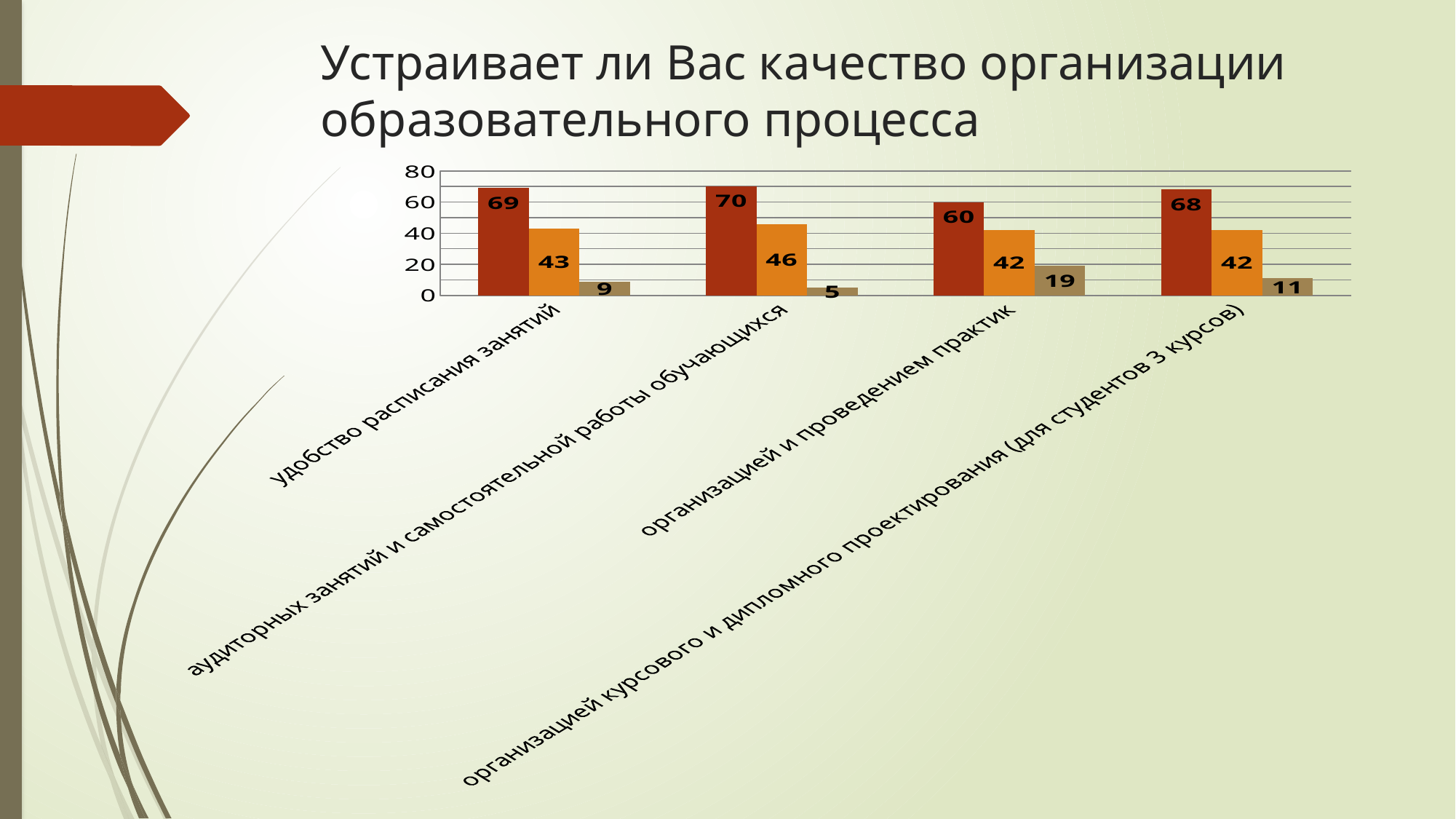
Is the dark red bar for "организацией и проведением практик" greater or less than 40? greater Which category has the highest dark red bar? аудиторных занятий и самостоятельной работы обучающихся Which category has the lowest tan bar? аудиторных занятий и самостоятельной работы обучающихся Which is larger: the tan bar for "удобство расписания занятий" or the tan bar for "организацией курсового и дипломного проектирования (для студентов 3 курсов)"? организацией курсового и дипломного проектирования (для студентов 3 курсов) What type of chart is shown on the slide? bar chart What is the title of the slide containing the chart? Устраивает ли Вас качество организации образовательного процесса What is the value of the orange bar for "аудиторных занятий и самостоятельной работы обучающихся"? 46 What is the value of the dark red bar for "организацией курсового и дипломного проектирования (для студентов 3 курсов)"? 68 What is the difference between the dark red bar and the orange bar for "организацией и проведением практик"? 18 How many categories are shown on the x axis of the chart? 4 What is the value of the dark red bar for "удобство расписания занятий"? 69 What is the value of the tan bar for "организацией и проведением практик"? 19